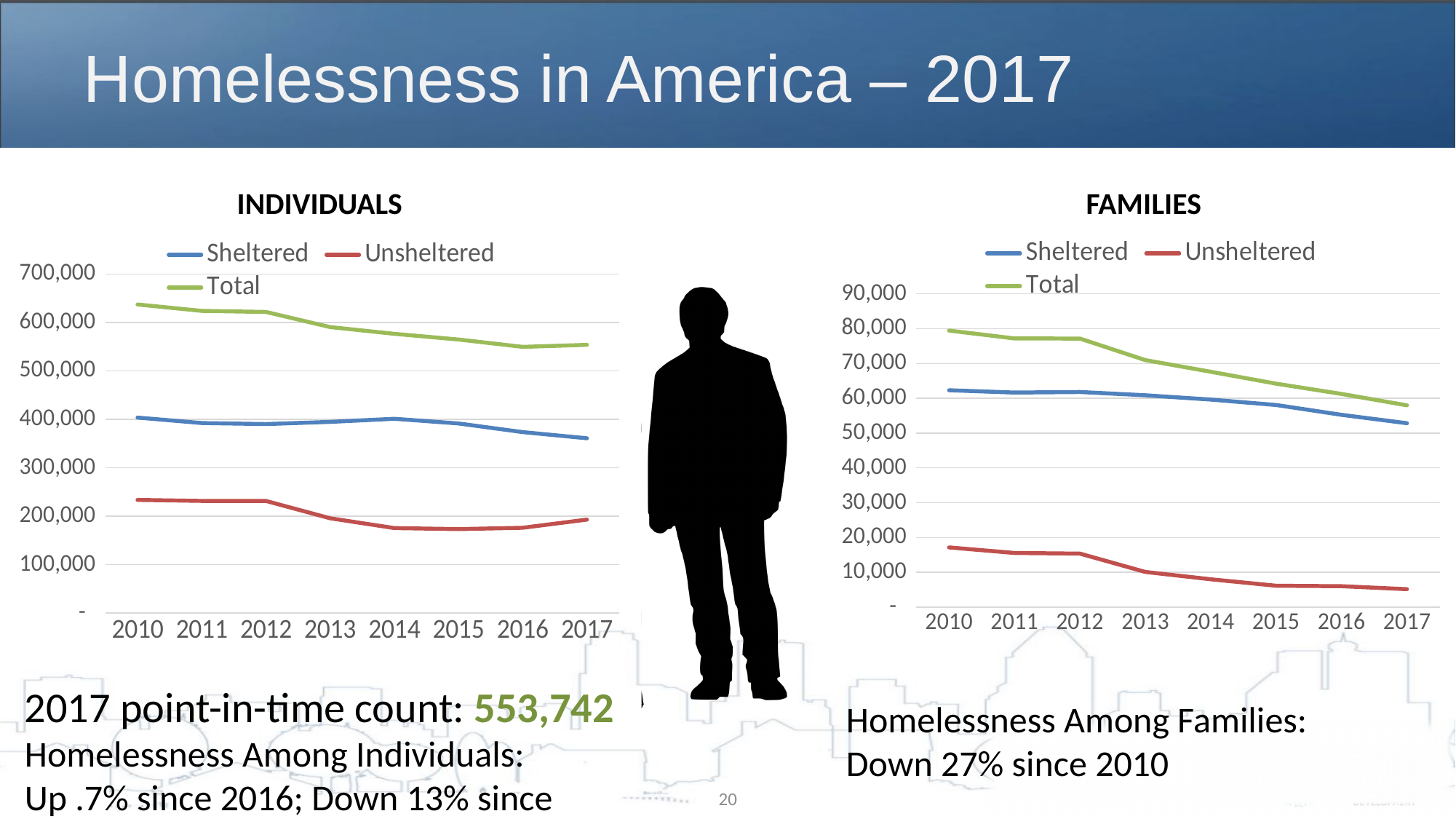
In the INDIVIDUALS chart, is the Sheltered value for 2017 greater or less than 400,000? less How many years are shown on the x axis of the INDIVIDUALS chart? 8 In the INDIVIDUALS chart, does the Total line rise or fall from 2010 to 2017? fall In the FAMILIES chart, which series has the lowest values across all years? Unsheltered In the FAMILIES chart, does the Total line rise or fall from 2010 to 2017? fall In the FAMILIES chart, is the Unsheltered value for 2017 greater or less than 10,000? less In the INDIVIDUALS chart, is the Unsheltered value for 2014 greater or less than 200,000? less How many series does the legend of the FAMILIES chart list? 3 In the INDIVIDUALS chart, which is larger in 2017, Sheltered or Unsheltered? Sheltered What kind of chart is the INDIVIDUALS chart? line chart